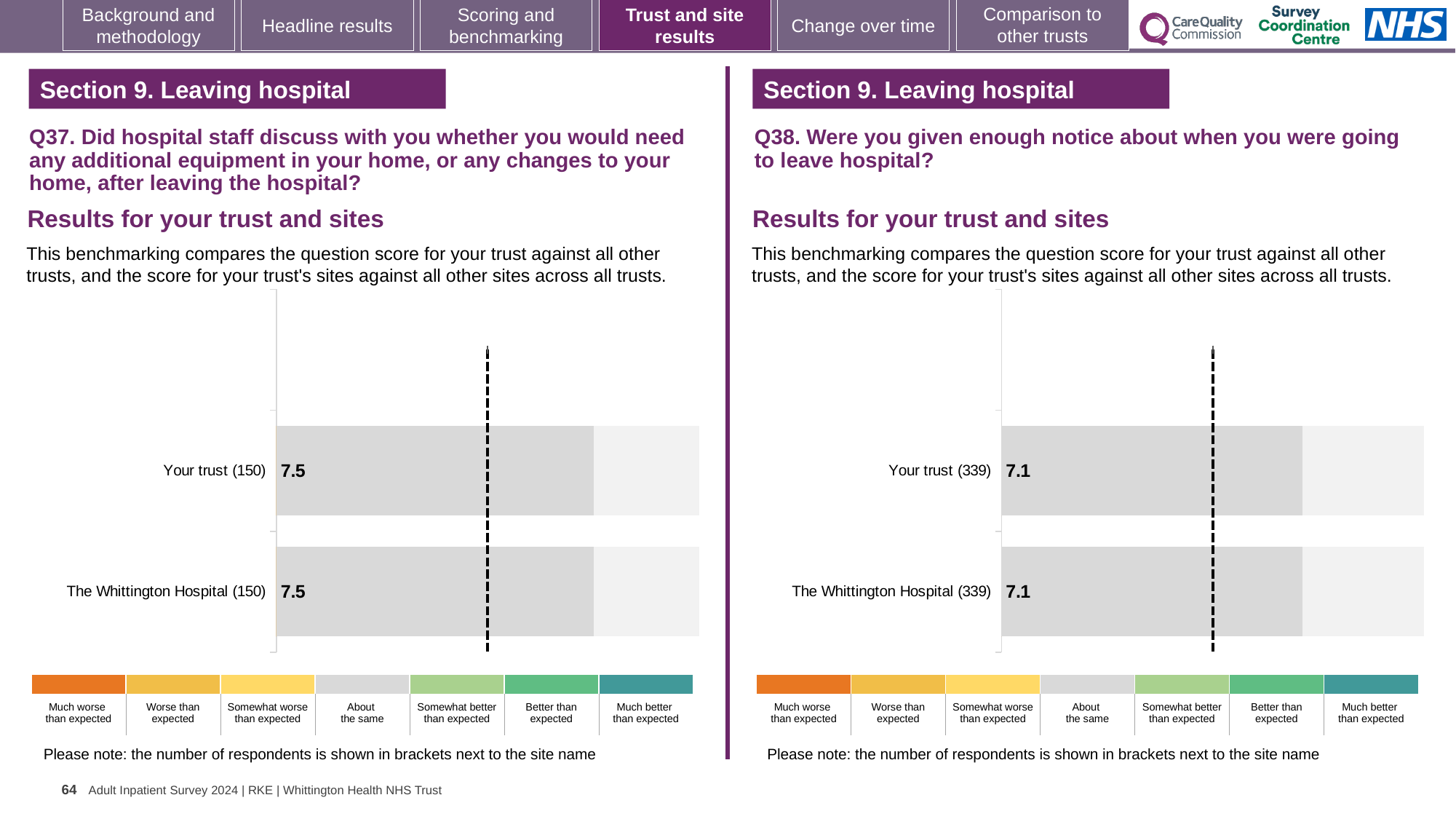
On the Q38 chart (right), what is the score for Your trust? 7.1 What type of chart is used on the Q38 chart (right)? Bar chart On the Q38 chart (right), what is the difference between the score for Your trust and the score for The Whittington Hospital? 0.0 How many bars are plotted on the Q38 chart (right)? 2 On the Q37 chart (left), what is the difference between the score for Your trust and the score for The Whittington Hospital? 0.0 How many bars are plotted on the Q37 chart (left)? 2 On the Q38 chart (right), what is the score for The Whittington Hospital? 7.1 Is the score for Your trust on the Q37 chart (left) larger than the score for Your trust on the Q38 chart (right)? Yes On the Q38 chart (right), how many respondents are shown in brackets next to The Whittington Hospital? 339 On the Q37 chart (left), what is the score for Your trust? 7.5 On the Q37 chart (left), what is the score for The Whittington Hospital? 7.5 On the Q37 chart (left), how many respondents are shown in brackets next to Your trust? 150